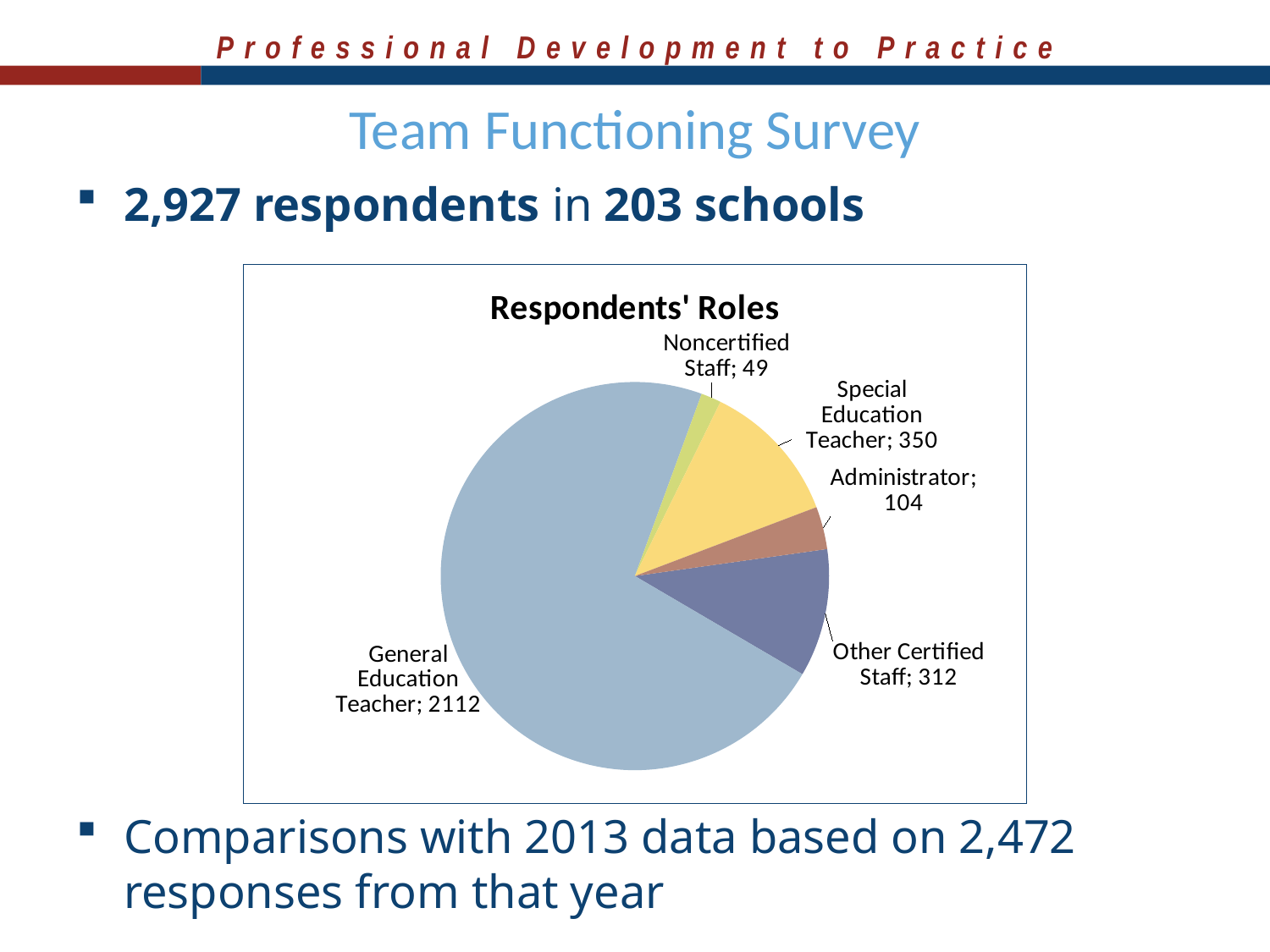
How many role categories are shown in the pie chart? 5 Which is larger, the number of Special Education Teachers or the number of Other Certified Staff? Special Education Teacher What is the title of the chart? Respondents' Roles Which role has the largest slice of the pie? General Education Teacher What is the difference between the number of Special Education Teachers and Other Certified Staff? 38 Which role has the smallest slice of the pie? Noncertified Staff How many respondents were General Education Teachers? 2112 How many respondents were Noncertified Staff? 49 How many respondents were Administrators? 104 What is the difference between the number of Administrators and Noncertified Staff? 55 What type of chart is shown on the slide? Pie chart How many respondents were Special Education Teachers? 350